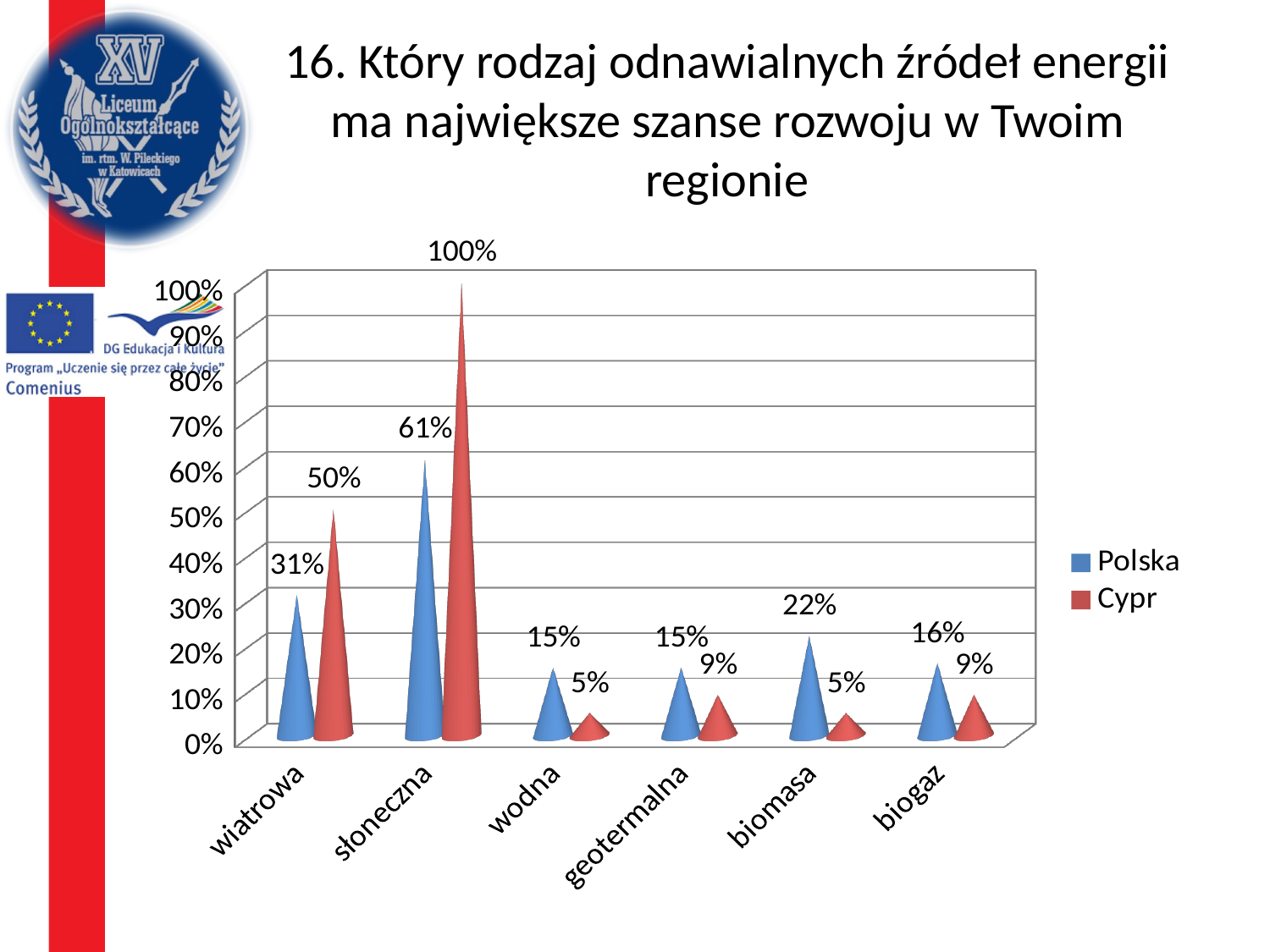
What is the value for Cypr in the wiatrowa category? 50% How many series does the legend list? 2 What is the value for Polska in the słoneczna category? 61% Which is larger for wiatrowa: the Polska value or the Cypr value? Cypr How many categories are shown on the x axis? 6 Which category has the lowest value for Polska? wodna and geotermalna (both 15%) Which colour represents the Cypr series in the legend? red Which category has the highest value for Cypr? słoneczna What is the value for Polska in the biomasa category? 22% What is the difference between the Cypr and Polska values for słoneczna? 39% What kind of chart is shown on the slide? bar chart What is the value for Cypr in the biogaz category? 9%